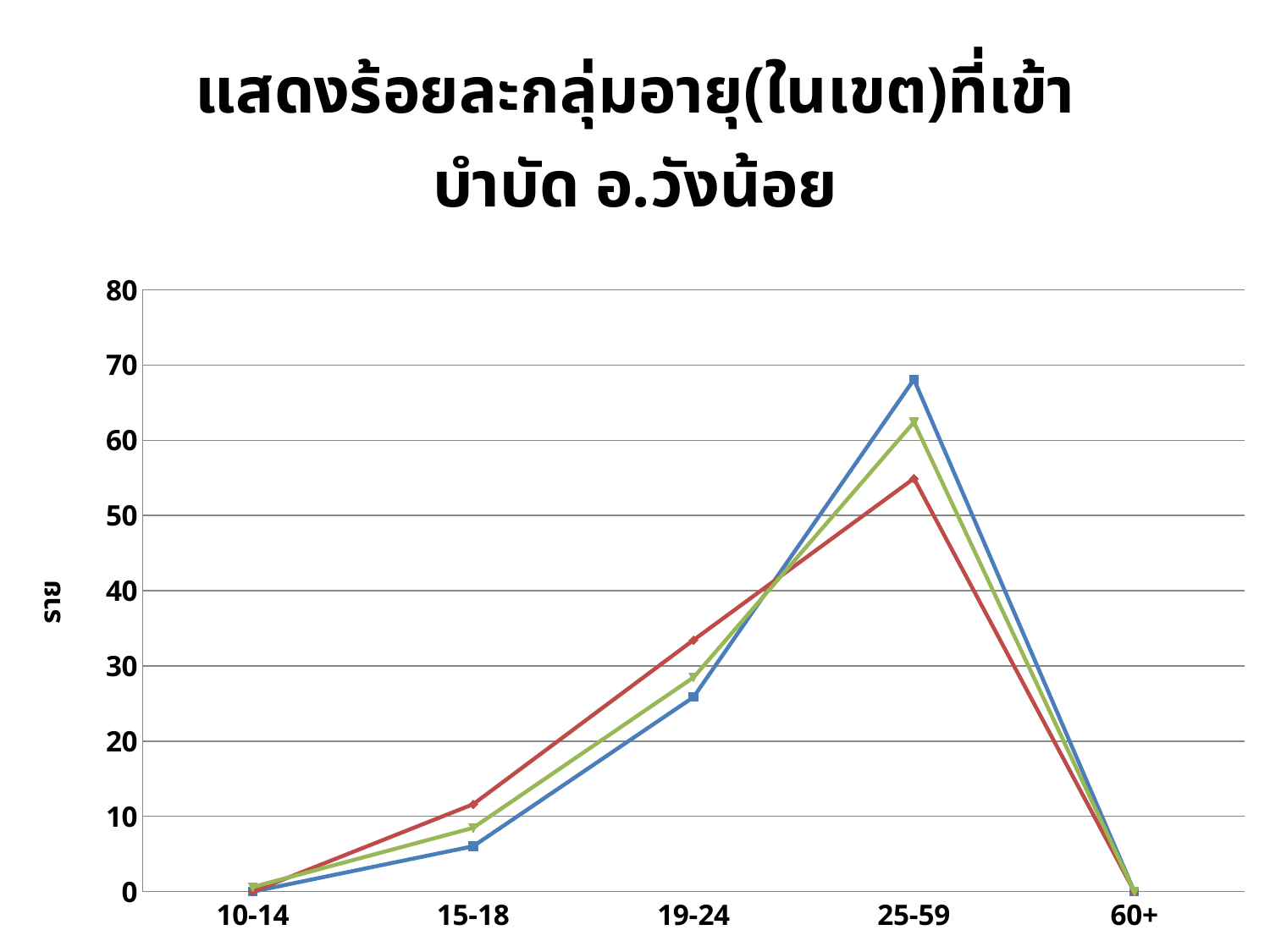
How many lines are plotted on the chart? 3 Is the value of the blue line for 15-18 greater or less than 10? less At 19-24, which line has the larger value, the red line or the blue line? red line At 25-59, which line has the larger value, the blue line or the red line? blue line Is the value of the red line for 19-24 greater or less than 30? greater What kind of chart is shown on the slide? line chart What is the label on the vertical axis? ราย Which age group has the highest value for the blue line? 25-59 Is the value of the blue line for 25-59 greater or less than 60? greater Which age group has the highest value for the red line? 25-59 How many age-group categories are shown on the x axis? 5